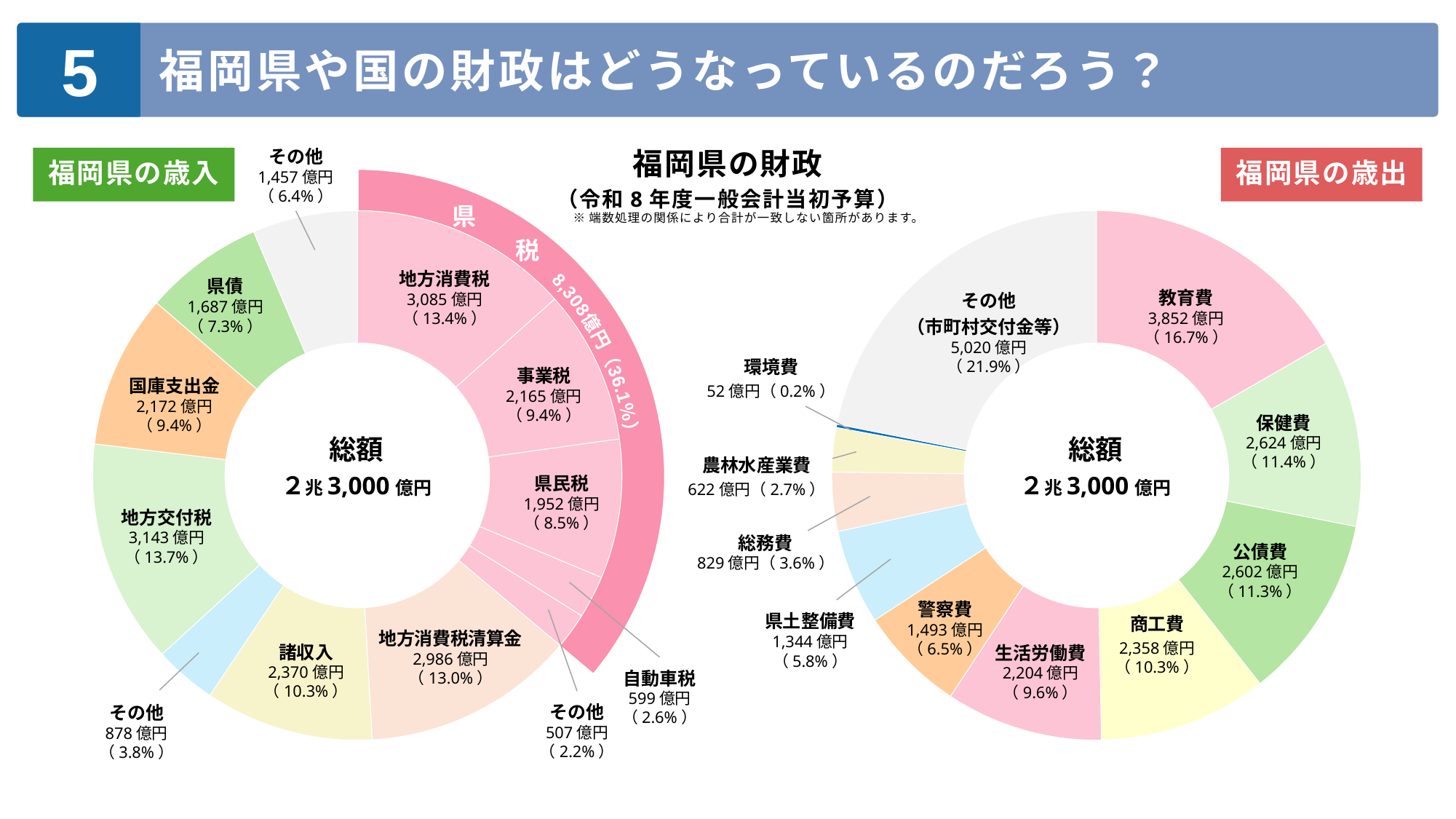
What kind of chart is used for 福岡県の歳出? Donut (pie) chart In the 福岡県の歳出 chart, which category has the largest share? その他（市町村交付金等） In the 福岡県の歳入 chart, what is the total amount of 県税 shown on the outer ring? 8,308億円 In the 福岡県の歳出 chart, which named expenditure category (excluding その他) has the smallest value? 環境費 In the 福岡県の歳出 chart, what is the value for 教育費? 3,852 億円 In the 福岡県の歳出 chart, what percentage share does 公債費 have? 11.3% In the 福岡県の歳入 chart, what is the total amount shown in the centre of the donut? 2兆3,000億円 In the 福岡県の歳入 chart, what is the difference between 地方消費税 and 事業税 in 億円? 920 億円 In the 福岡県の歳出 chart, what is the difference between 警察費 and 県土整備費 in 億円? 149 億円 In the 福岡県の歳出 chart, which is larger: 保健費 or 商工費? 保健費 What fiscal year and budget does the slide's chart title refer to? 令和8年度一般会計当初予算 In the 福岡県の歳入 chart, what is the value for 地方交付税? 3,143 億円